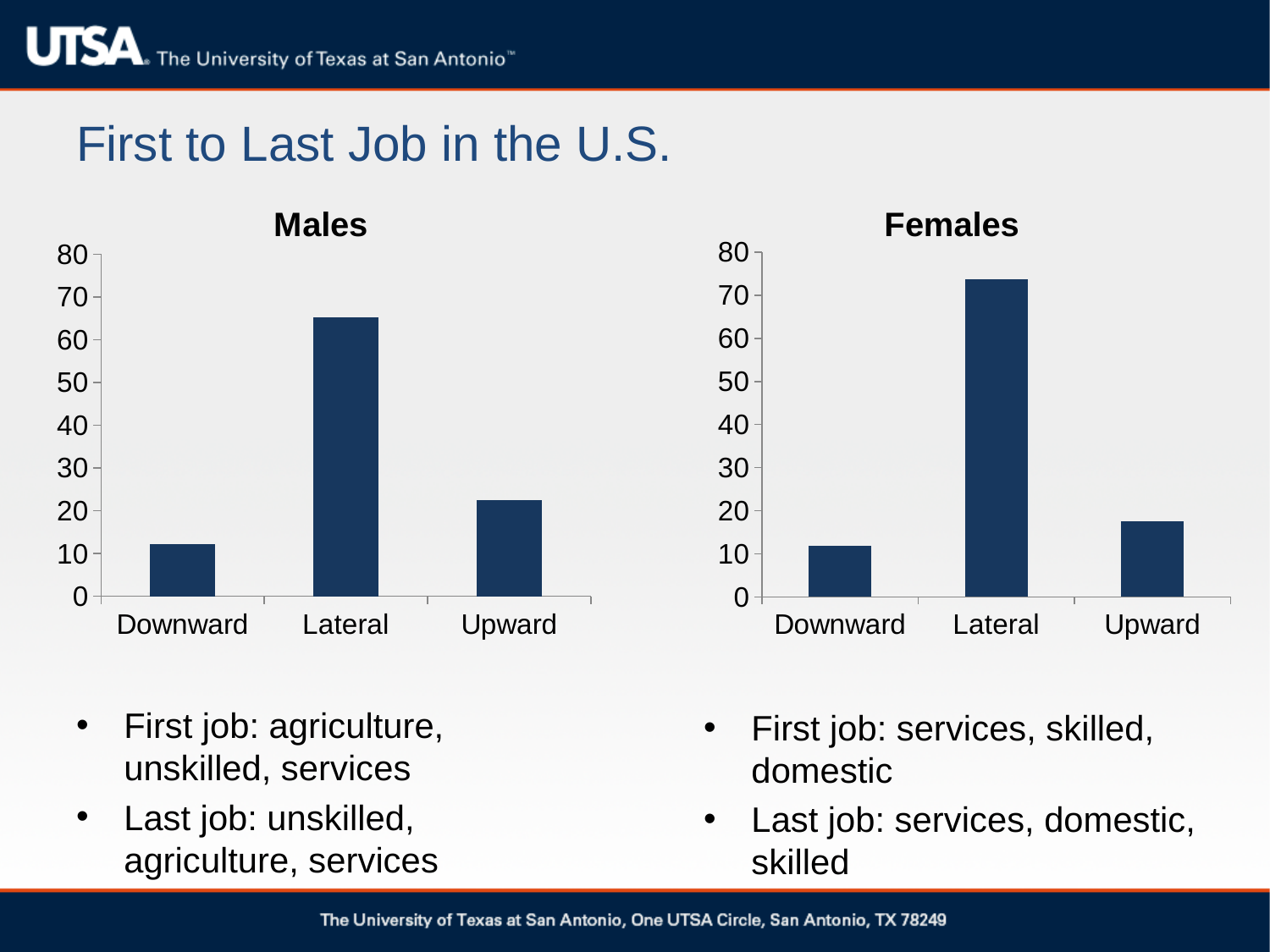
In the Males chart, which is larger, the value for Upward or the value for Downward? Upward In the Females chart, is the value for Lateral greater or less than 70? greater In the Females chart, which category has the lowest value? Downward In the Females chart, is the value for Downward greater or less than 20? less In the Males chart, which category has the lowest value? Downward In the Males chart, is the value for Upward greater or less than 30? less What kind of chart is the Males chart? Bar chart How many categories are shown in the Females chart? 3 What is the title of the chart on the right side of the slide? Females In the Males chart, which category has the highest value? Lateral In the Females chart, which category has the highest value? Lateral